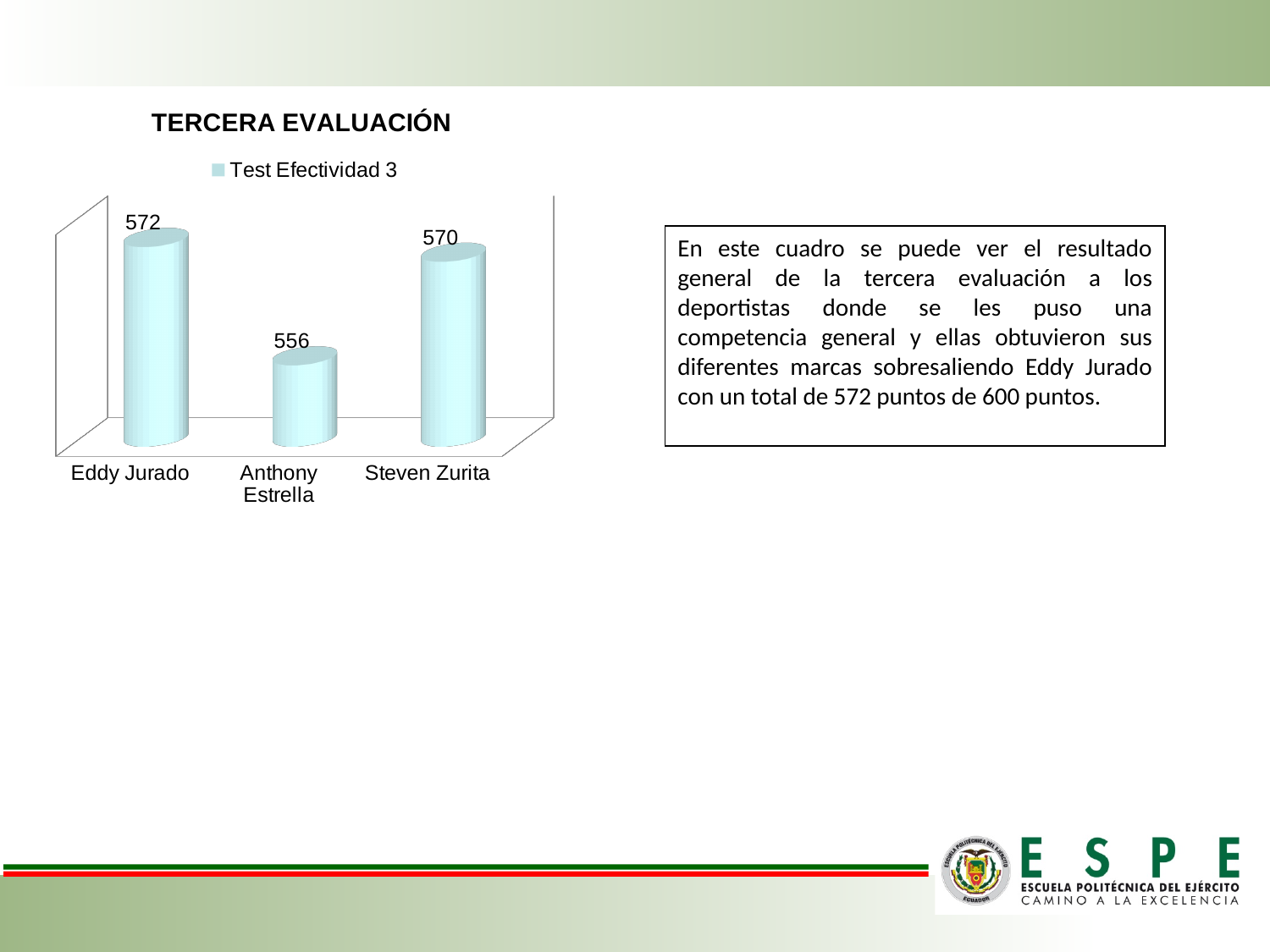
Which category has the highest value? Eddy Jurado What is the difference between the values for Eddy Jurado and Anthony Estrella? 16 What kind of chart is shown on the slide? Bar chart How many categories are shown in the chart? 3 What is the difference between the values for Steven Zurita and Anthony Estrella? 14 What is the value for Eddy Jurado? 572 How many series does the legend list? 1 What is the series name shown in the legend? Test Efectividad 3 Which is larger, the value for Eddy Jurado or the value for Steven Zurita? Eddy Jurado What is the value for Anthony Estrella? 556 What is the value for Steven Zurita? 570 Which category has the lowest value? Anthony Estrella